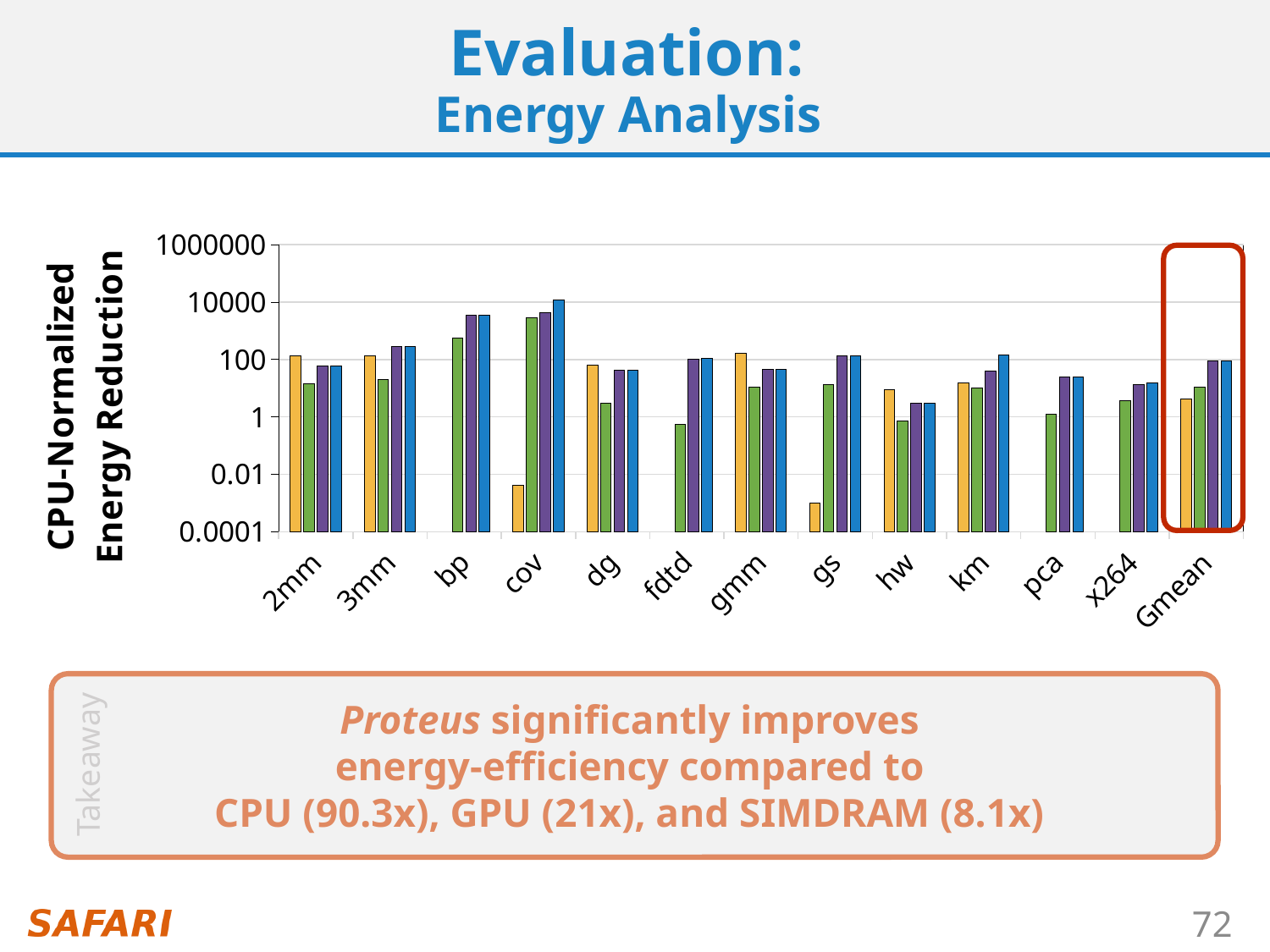
Which category contains the tallest bar in the chart? cov How many bars are plotted for the 2mm category? 4 Which category on the x axis is highlighted with a red box? Gmean Is the value of the yellow bar for Gmean greater or less than 1? greater Which category contains the shortest bar in the chart? gs What kind of chart is shown on the slide? bar chart For the 2mm category, which is taller: the yellow bar or the green bar? the yellow bar Is the value of the blue bar for bp greater or less than 100? greater Is the value of the yellow bar for cov greater or less than 0.01? less How many categories are shown along the x axis of the chart? 13 What is the label of the y axis of the chart? CPU-Normalized Energy Reduction